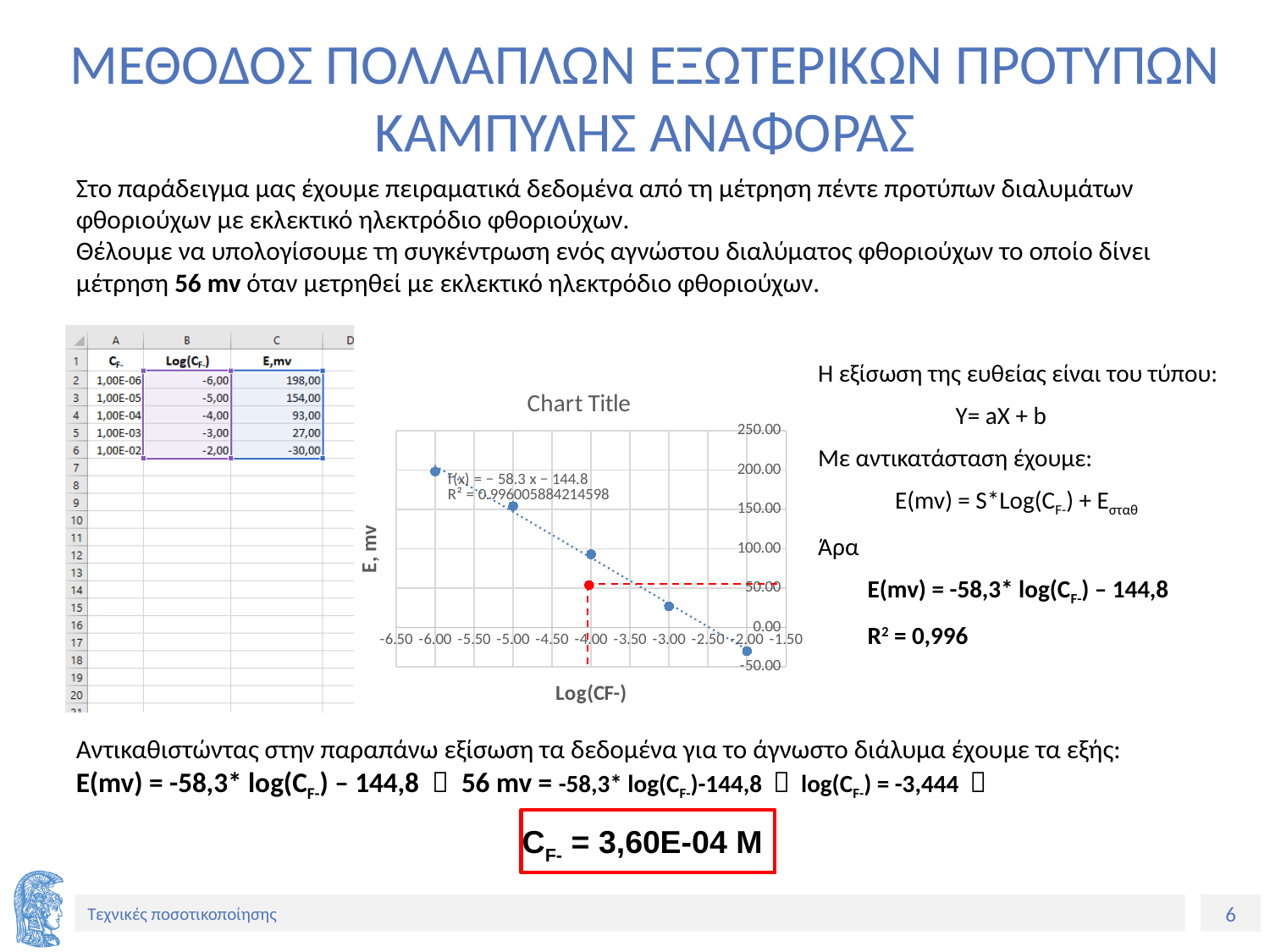
At which Log(CF-) value is the plotted E, mv value lowest? -2.00 Do the plotted E, mv values rise or fall as Log(CF-) increases along the x axis? fall Which point has a larger E, mv value: the one at Log(CF-) = -5.00 or the one at Log(CF-) = -4.00? -5.00 What kind of chart is shown on the slide? scatter chart At which Log(CF-) value is the plotted E, mv value highest? -6.00 Is the E, mv value of the point at Log(CF-) = -6.00 greater or less than 150.00? greater Is the E, mv value of the point at Log(CF-) = -2.00 greater or less than 0.00? less What is the label of the x axis of the chart? Log(CF-) Is the E, mv value of the point at Log(CF-) = -3.00 greater or less than 50.00? less What trendline equation is printed on the chart? f(x) = − 58.3 x − 144.8 How many blue data points are plotted on the chart? 5 What is the title of the chart? Chart Title